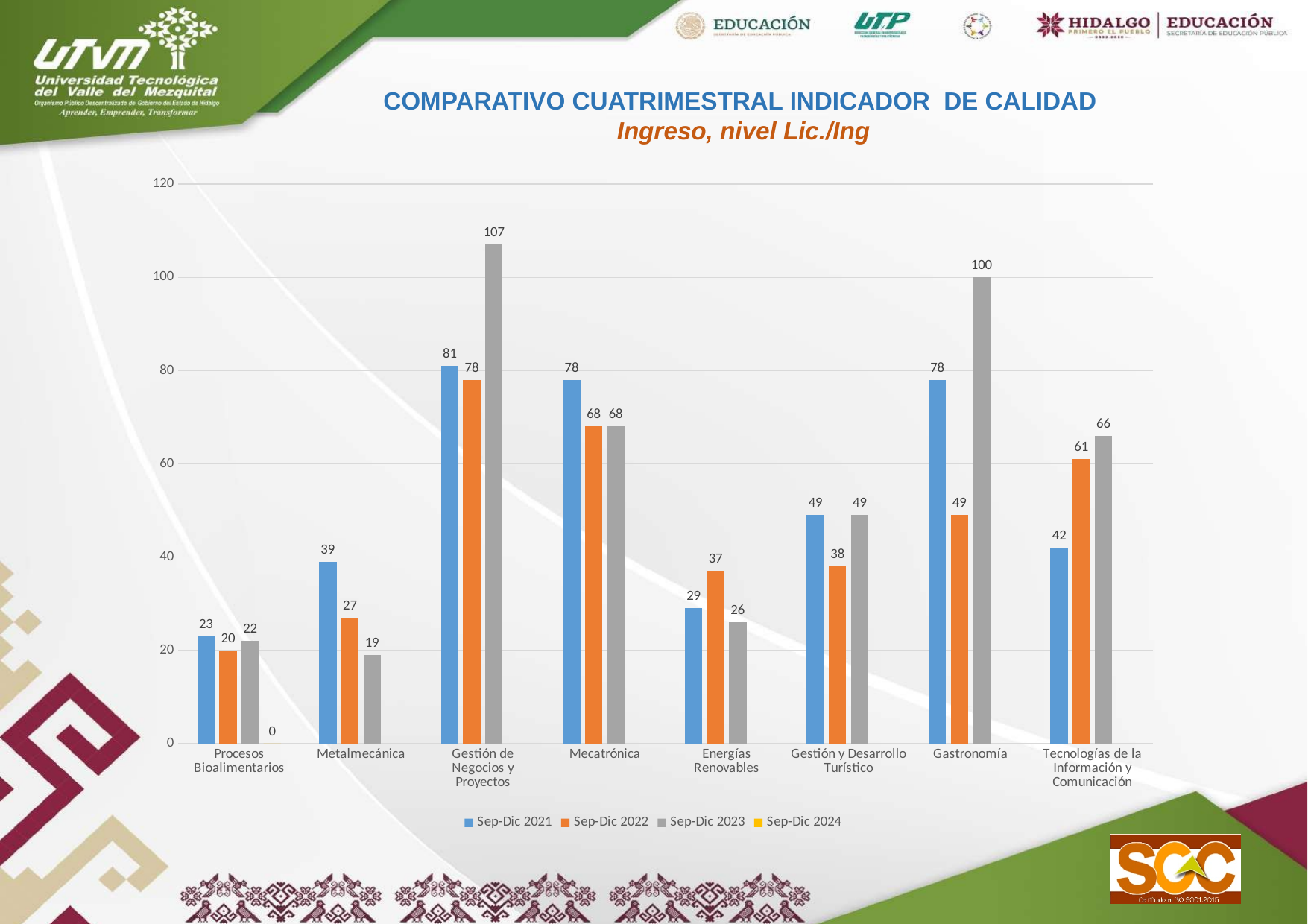
What is the difference between the Sep-Dic 2021 and Sep-Dic 2022 values for Gastronomía? 29 What kind of chart is shown on the slide? Bar chart What is the difference between the Sep-Dic 2023 and Sep-Dic 2021 values for Gestión de Negocios y Proyectos? 26 Which category has the highest value in the Sep-Dic 2023 series? Gestión de Negocios y Proyectos How many series does the legend list? 4 Which is larger for Tecnologías de la Información y Comunicación: the Sep-Dic 2021 value or the Sep-Dic 2022 value? Sep-Dic 2022 How many categories are shown on the x axis? 8 What is the value for Energías Renovables in the Sep-Dic 2022 series? 37 Which series is shown in orange in the legend? Sep-Dic 2022 Which category has the lowest value in the Sep-Dic 2022 series? Procesos Bioalimentarios What is the value for Gastronomía in the Sep-Dic 2023 series? 100 What is the value for Metalmecánica in the Sep-Dic 2021 series? 39